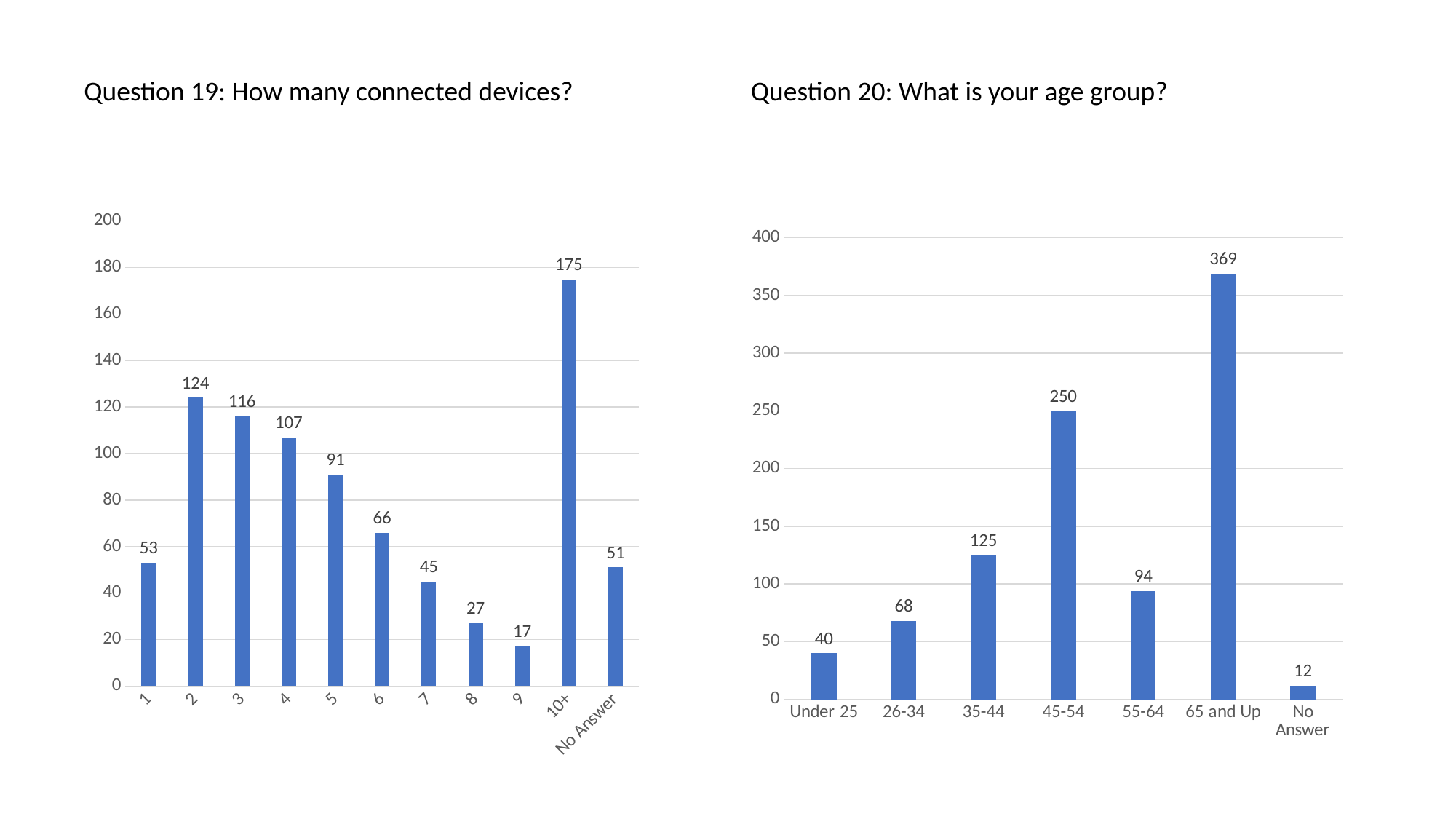
In the 'Question 19: How many connected devices?' chart, which category has the highest value? 10+ In the 'Question 20: What is your age group?' chart, which age group has the highest value? 65 and Up What kind of chart is the 'Question 20: What is your age group?' chart? Bar chart In the 'Question 20: What is your age group?' chart, which category has the lowest value? No Answer In the 'Question 20: What is your age group?' chart, what is the difference between the values for 65 and Up and 45-54? 119 In the 'Question 20: What is your age group?' chart, what is the value for 45-54? 250 In the 'Question 19: How many connected devices?' chart, what is the difference between the values for 2 and 5? 33 In the 'Question 19: How many connected devices?' chart, which is larger, the value for 1 or the value for No Answer? 1 In the 'Question 19: How many connected devices?' chart, what is the value for category 3? 116 In the 'Question 20: What is your age group?' chart, how many categories are shown on the x axis? 7 In the 'Question 19: How many connected devices?' chart, how many categories are shown on the x axis? 11 In the 'Question 19: How many connected devices?' chart, which category has the lowest value? 9